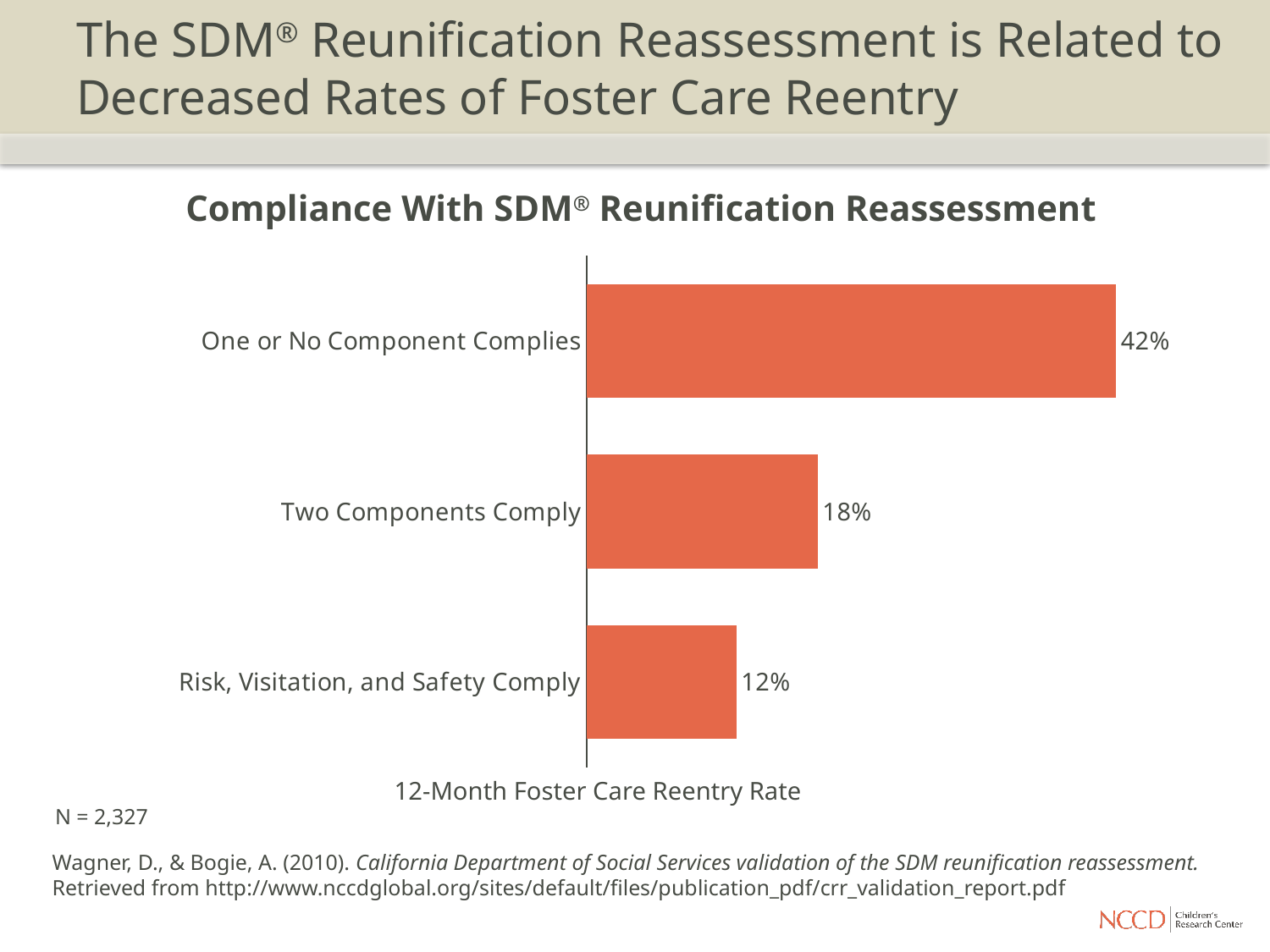
What is the 12-month foster care reentry rate for 'Risk, Visitation, and Safety Comply'? 12% What is the difference in reentry rate between 'Two Components Comply' and 'Risk, Visitation, and Safety Comply'? 6% What is the title of the chart? Compliance With SDM® Reunification Reassessment What type of chart is shown on the slide? Bar chart What is the difference in reentry rate between 'One or No Component Complies' and 'Two Components Comply'? 24% What is the 12-month foster care reentry rate for 'One or No Component Complies'? 42% Which category has the highest 12-month foster care reentry rate? One or No Component Complies What is the sample size (N) noted on the slide? N = 2,327 How many categories are shown in the chart? 3 Which category has the lowest 12-month foster care reentry rate? Risk, Visitation, and Safety Comply What is the 12-month foster care reentry rate for 'Two Components Comply'? 18% Which has a higher reentry rate: 'Two Components Comply' or 'Risk, Visitation, and Safety Comply'? Two Components Comply